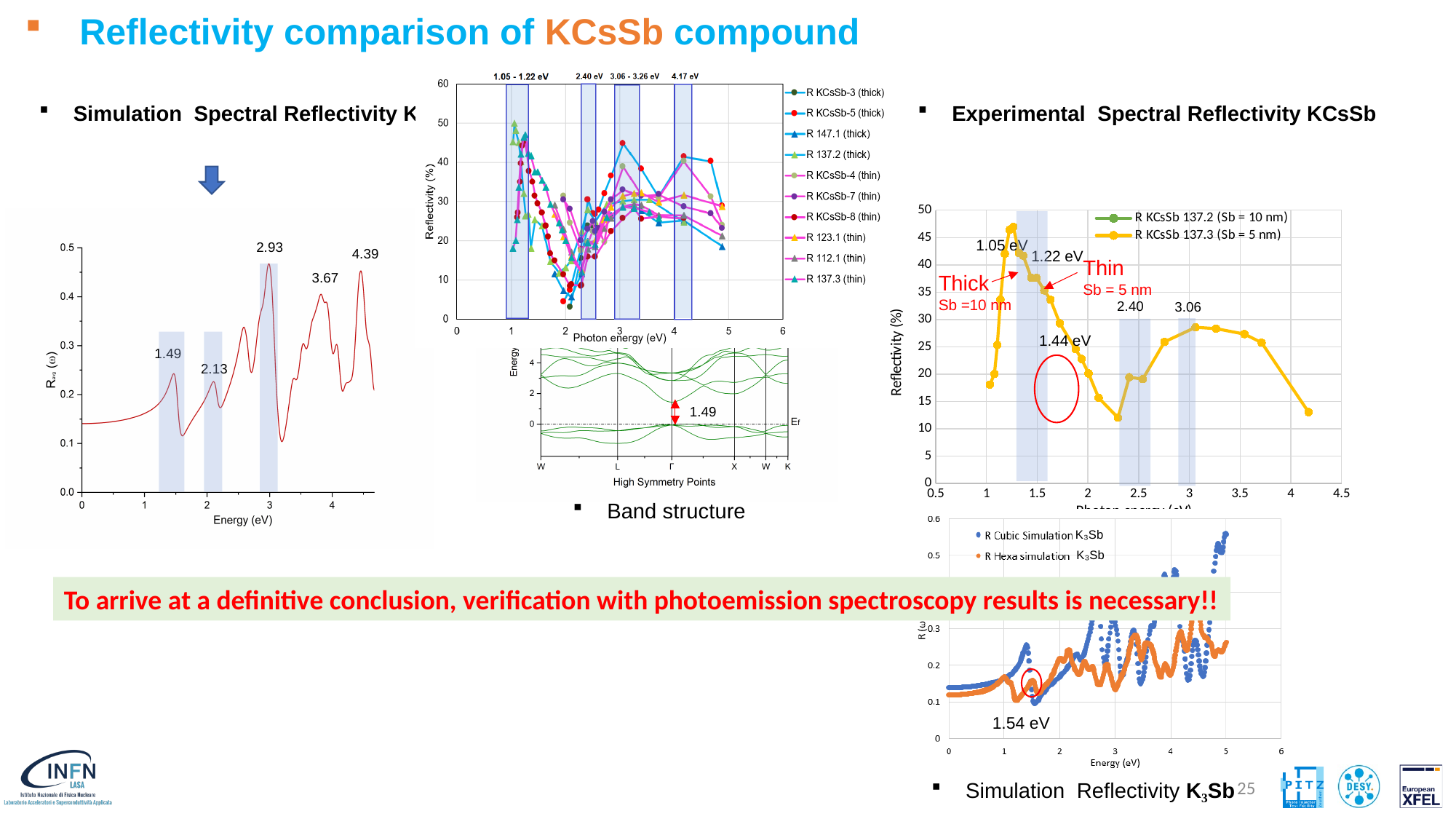
In the Experimental Spectral Reflectivity KCsSb chart, does the reflectivity rise or fall between 3.5 eV and 4.2 eV? fall What is the x-axis label of the middle top chart (Reflectivity vs Photon energy)? Photon energy (eV) In the Experimental Spectral Reflectivity KCsSb chart, what Sb thickness is given for the R KCsSb 137.3 series? Sb = 5 nm In the Experimental Spectral Reflectivity KCsSb chart, is the reflectivity of the R KCsSb 137.3 series at its minimum near 2.3 eV greater or less than 15? less How many series does the legend of the Experimental Spectral Reflectivity KCsSb chart list? 2 In the Experimental Spectral Reflectivity KCsSb chart, is the peak reflectivity of the R KCsSb 137.3 series near 1.2 eV greater or less than 40? greater How many series does the legend of the Simulation Reflectivity K3Sb chart (bottom right) list? 2 In the Simulation Spectral Reflectivity KCsSb chart on the left, how many peaks are labeled with energy values? 5 How many series does the legend of the middle top chart (Reflectivity vs Photon energy) list? 10 In the Simulation Spectral Reflectivity KCsSb chart on the left, what energy value labels the highest peak? 2.93 What kind of chart is the Experimental Spectral Reflectivity KCsSb chart? Line chart What kind of chart is the Simulation Reflectivity K3Sb chart at the bottom right? Scatter chart